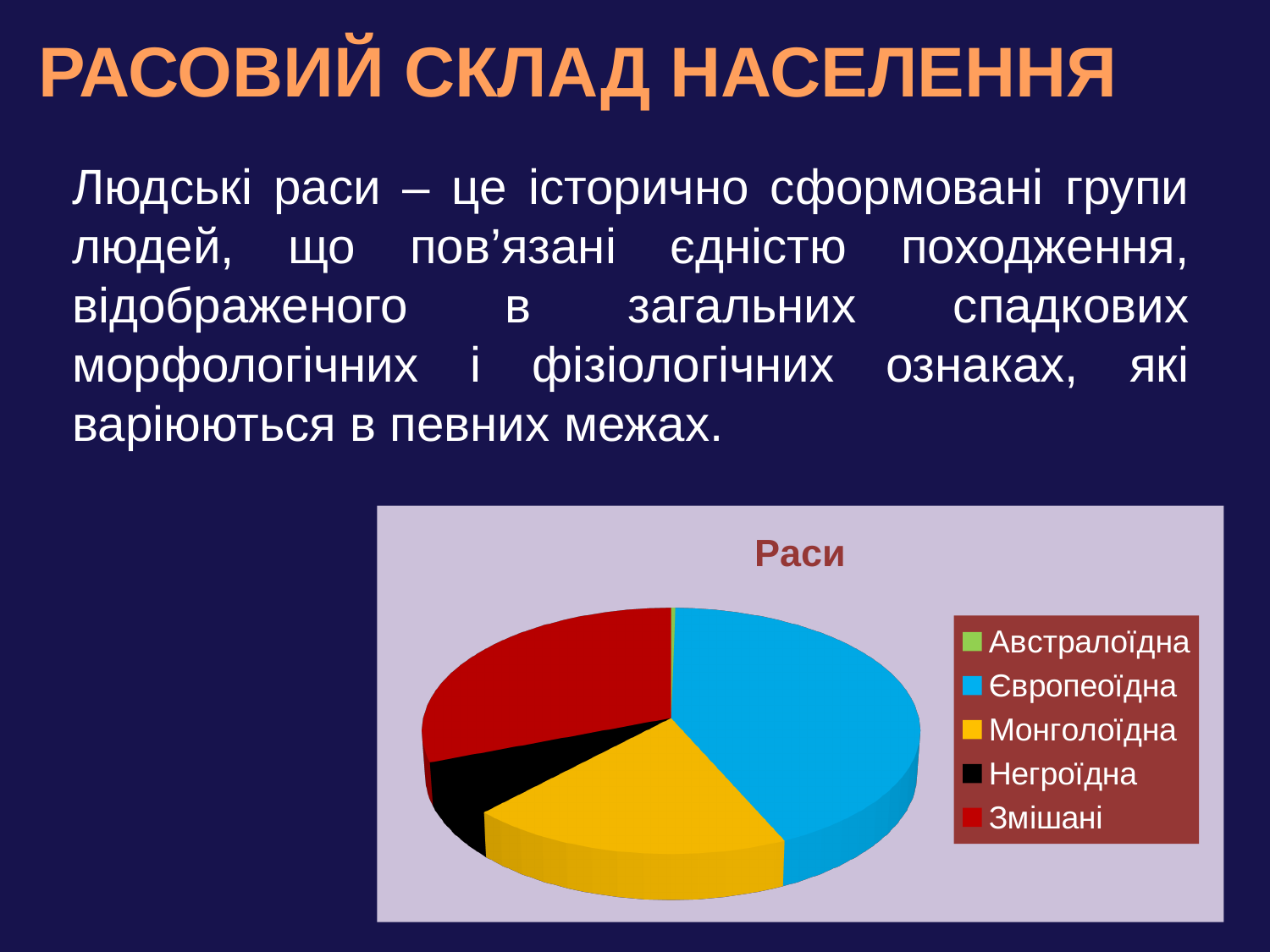
Which slice is larger, Монголоїдна or Австралоїдна? Монголоїдна What kind of chart is shown on the slide? pie chart Which category has the smallest slice of the pie? Австралоїдна Which slice is larger, Європеоїдна or Монголоїдна? Європеоїдна How many categories does the pie chart show? 5 What is the title of the chart? Раси Which slice is larger, Європеоїдна or Негроїдна? Європеоїдна What colour is the Негроїдна slice in the pie chart? black Which category has the largest slice of the pie? Європеоїдна